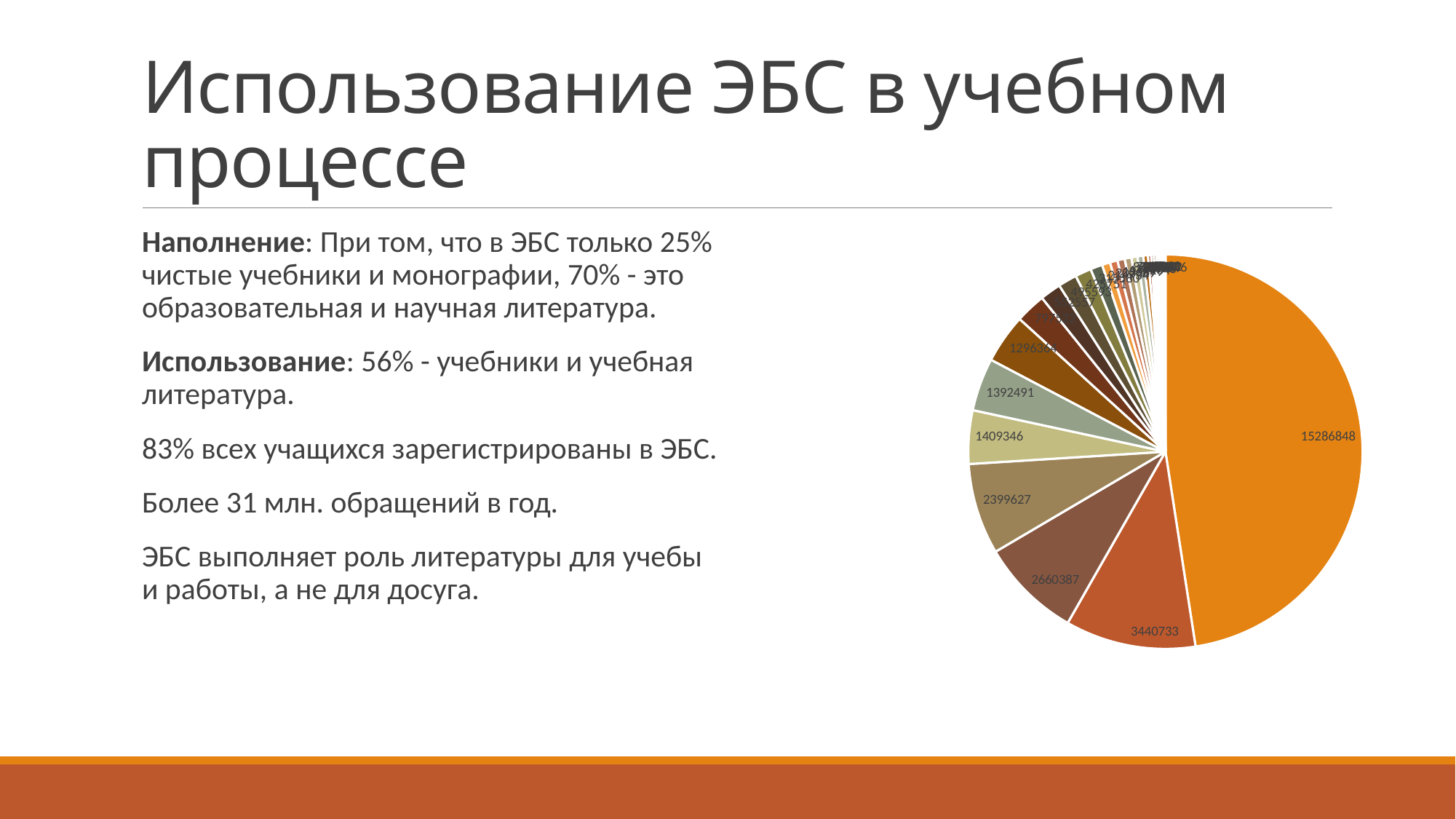
What is the value printed on the largest slice of the pie chart? 15286848 Which is larger: the slice labelled 2399627 or the slice labelled 1409346? 2399627 What is the value printed on the second-largest slice of the pie chart? 3440733 What is the difference between the largest slice (15286848) and the second-largest slice (3440733)? 11846115 Is the largest slice of the pie chart greater or less than half of the pie? less What is the value printed on the third-largest slice of the pie chart? 2660387 What is the difference between the slices labelled 2660387 and 2399627? 260760 What is the difference between the slices labelled 1409346 and 1392491? 16855 What kind of chart is shown on the slide? pie chart What colour is the largest slice of the pie chart? orange Does the pie chart have a legend? No